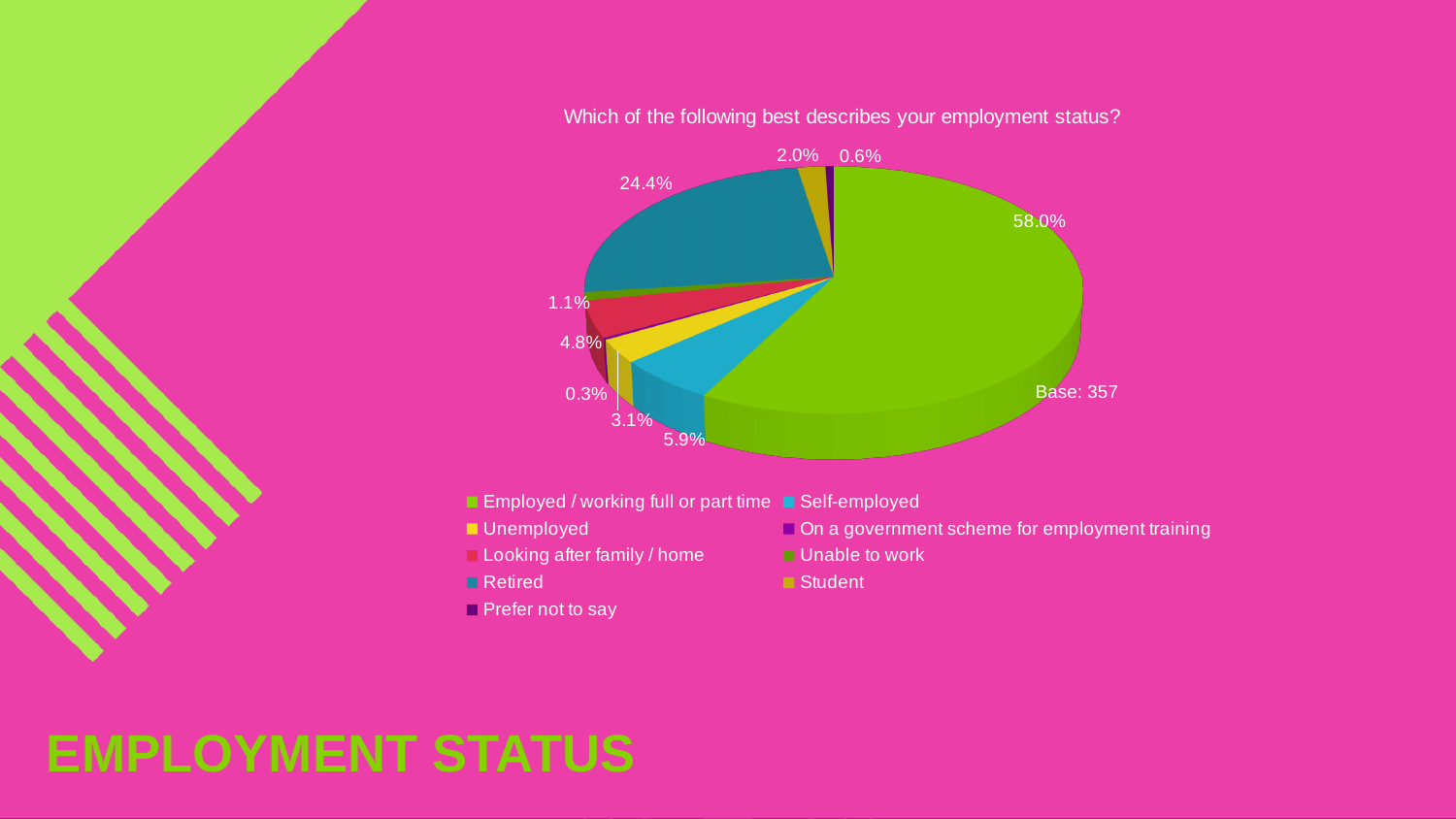
Which is larger: the share for self-employed or the share for looking after family / home? Self-employed How many employment status categories are shown in the pie chart? 9 Which employment status has the smallest share of the pie? On a government scheme for employment training What is the difference in percentage points between the employed / working full or part time share and the retired share? 33.6% What percentage of respondents are retired? 24.4% What percentage of respondents are employed / working full or part time? 58.0% What percentage of respondents are students? 2.0% What type of chart is shown on the slide? Pie chart Which employment status has the largest share of the pie? Employed / working full or part time What percentage of respondents are looking after family / home? 4.8% What is the base (number of respondents) shown on the chart? 357 What percentage of respondents are self-employed? 5.9%